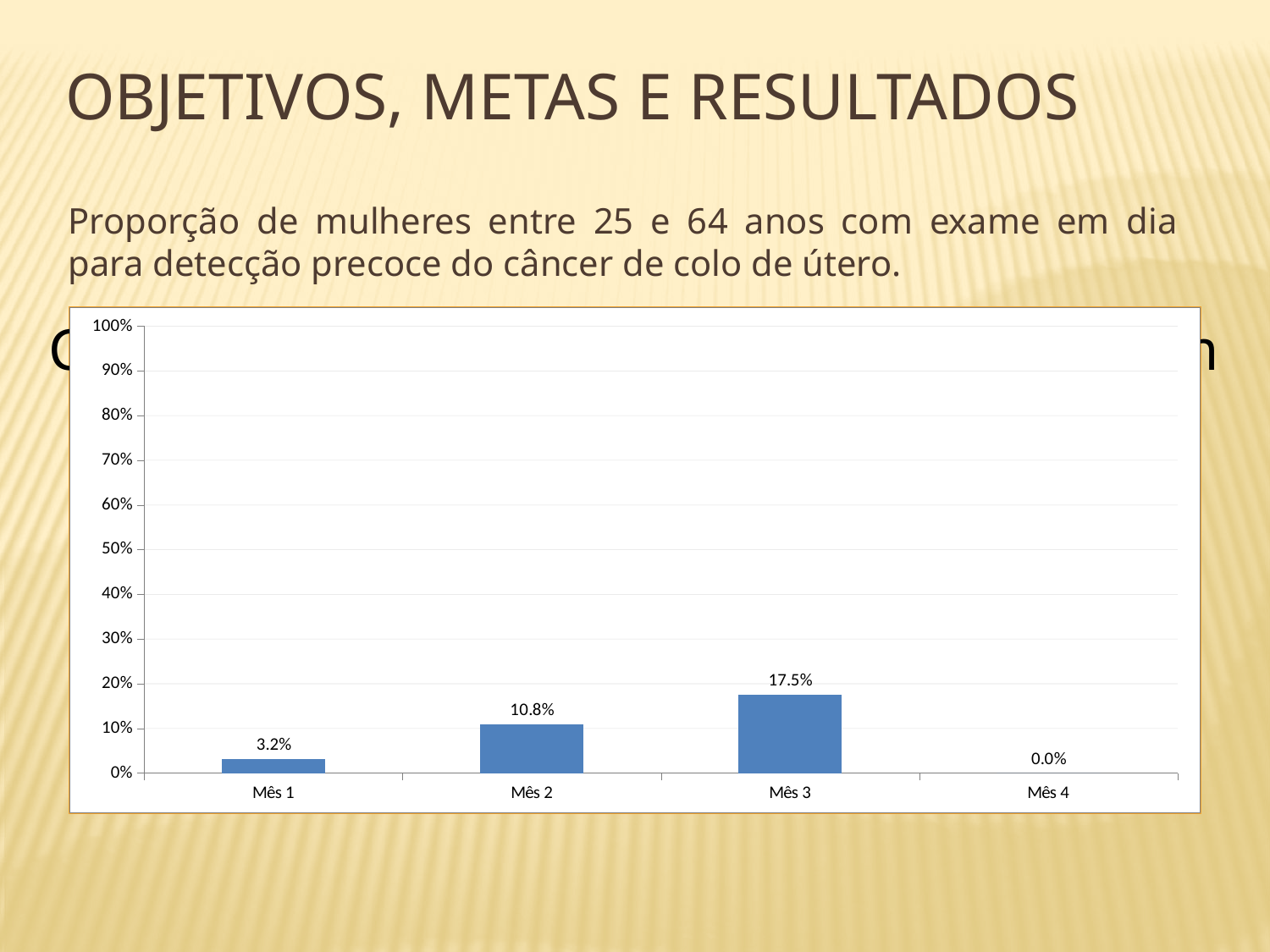
What is the value for Mês 2? 10.8% What is the difference between the values for Mês 3 and Mês 2? 6.7% What is the value for Mês 3? 17.5% What is the value for Mês 4? 0.0% Which month has the lowest value? Mês 4 Which is larger, the value for Mês 1 or the value for Mês 2? Mês 2 Which month has the highest value? Mês 3 What is the difference between the values for Mês 2 and Mês 1? 7.6% What is the value for Mês 1? 3.2% Is the value for Mês 3 greater or less than 20%? less What kind of chart is shown on the slide? bar chart How many months are shown on the x axis? 4